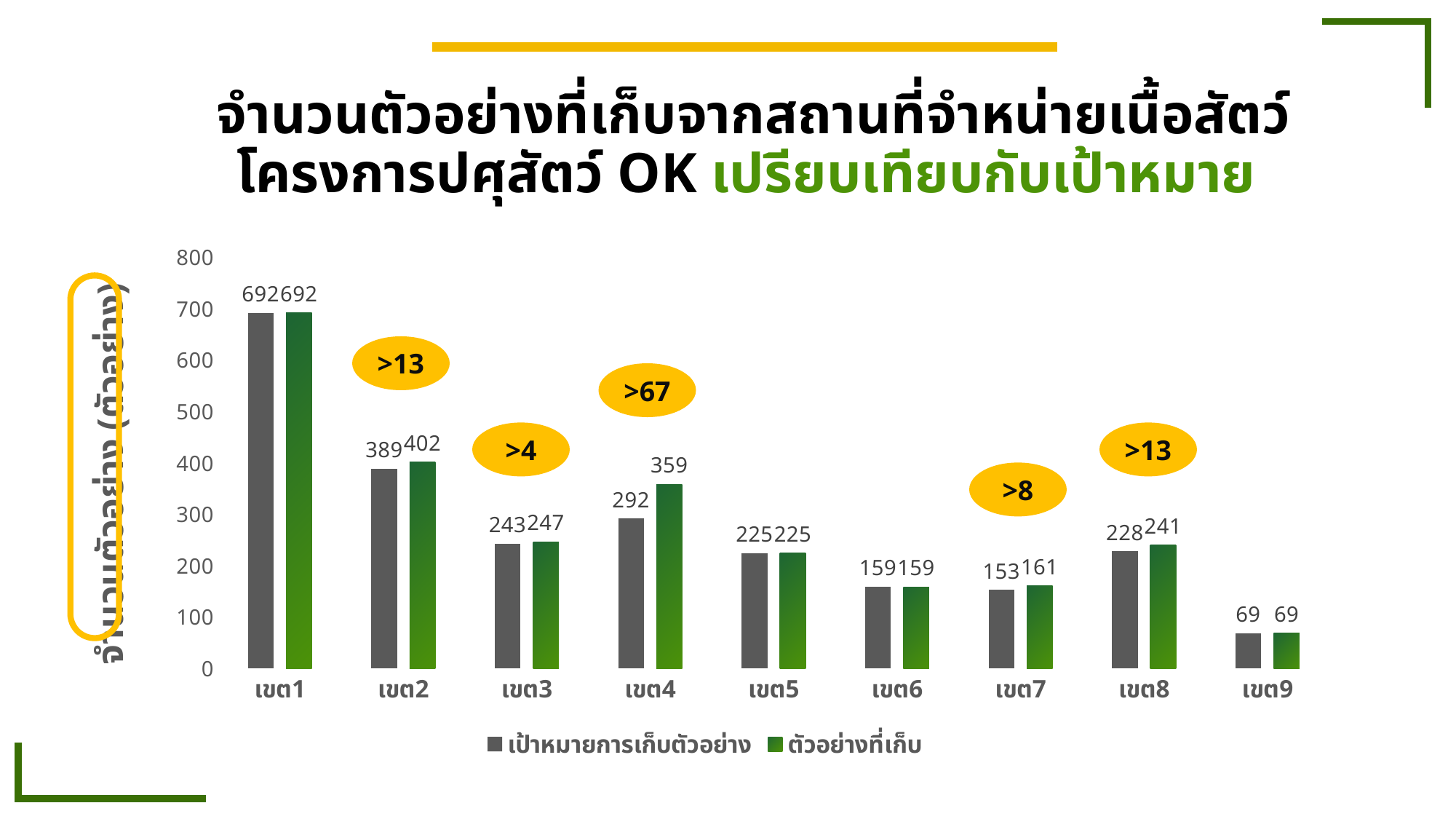
What is the value of เป้าหมายการเก็บตัวอย่าง for เขต2? 389 What is the difference between ตัวอย่างที่เก็บ and เป้าหมายการเก็บตัวอย่าง for เขต7? 8 Which is larger: ตัวอย่างที่เก็บ for เขต3 or ตัวอย่างที่เก็บ for เขต5? เขต3 What kind of chart is shown on the slide? Bar chart What is the difference between ตัวอย่างที่เก็บ and เป้าหมายการเก็บตัวอย่าง for เขต4? 67 Which category has the lowest value for เป้าหมายการเก็บตัวอย่าง? เขต9 How many series does the legend list? 2 What is the value of ตัวอย่างที่เก็บ for เขต8? 241 Which category has the highest value for ตัวอย่างที่เก็บ? เขต1 What is the value of ตัวอย่างที่เก็บ for เขต4? 359 What is the value of เป้าหมายการเก็บตัวอย่าง for เขต6? 159 How many categories are shown on the x axis? 9